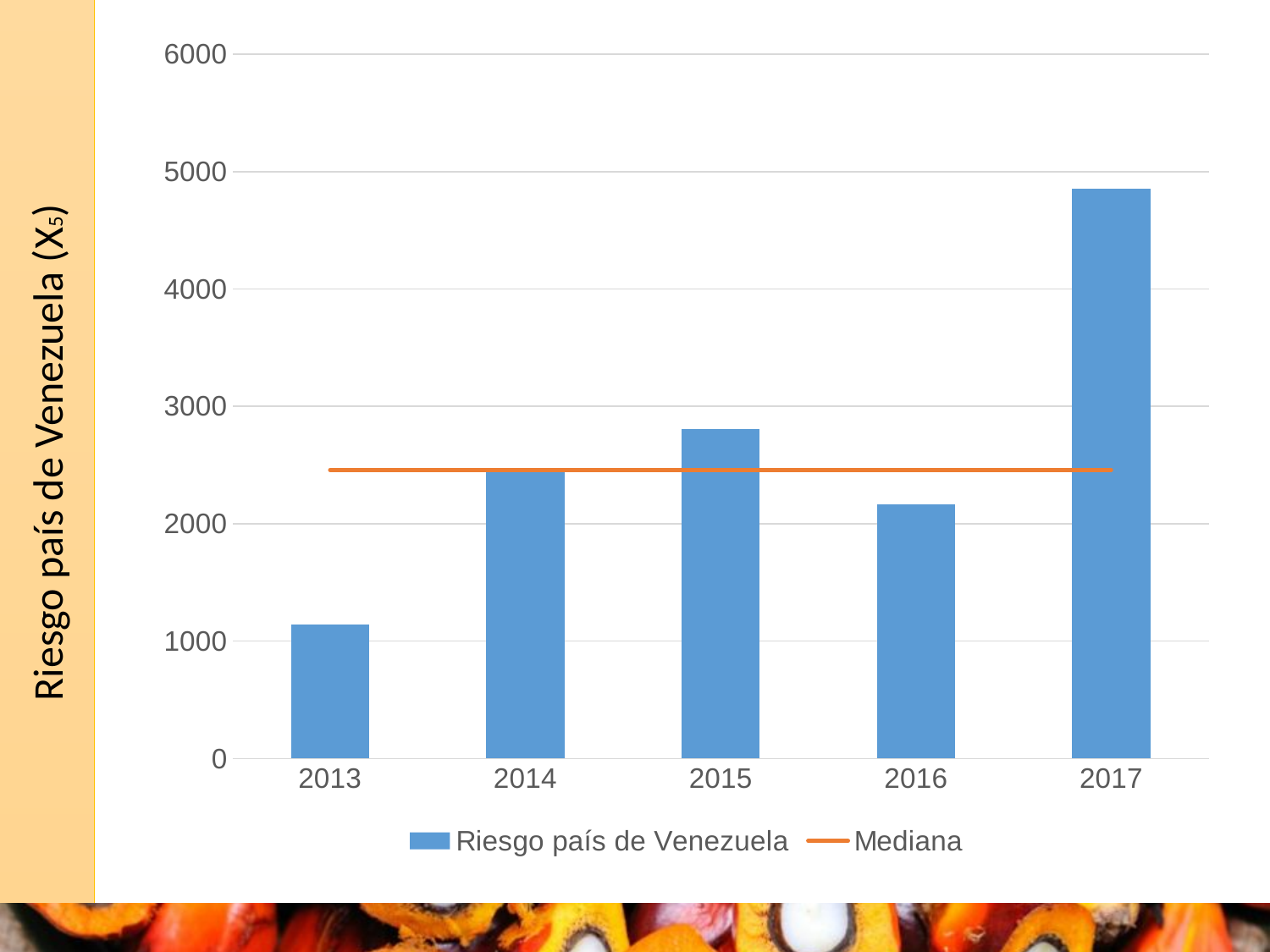
How many series does the legend list? 2 Which year has the highest value for Riesgo país de Venezuela? 2017 Which year has the larger value for Riesgo país de Venezuela, 2015 or 2016? 2015 Which year has the lowest value for Riesgo país de Venezuela? 2013 Is the value for Riesgo país de Venezuela in 2013 greater or less than 2000? less Does the value for Riesgo país de Venezuela rise or fall from 2016 to 2017? rise How many years are shown on the x axis? 5 Is the value for Riesgo país de Venezuela in 2015 greater or less than 3000? less What kind of chart is shown on the slide? combination bar and line chart What is the name of the series drawn as an orange line in the legend? Mediana Is the value for Riesgo país de Venezuela in 2017 greater or less than 4000? greater Which year has the larger value for Riesgo país de Venezuela, 2013 or 2016? 2016